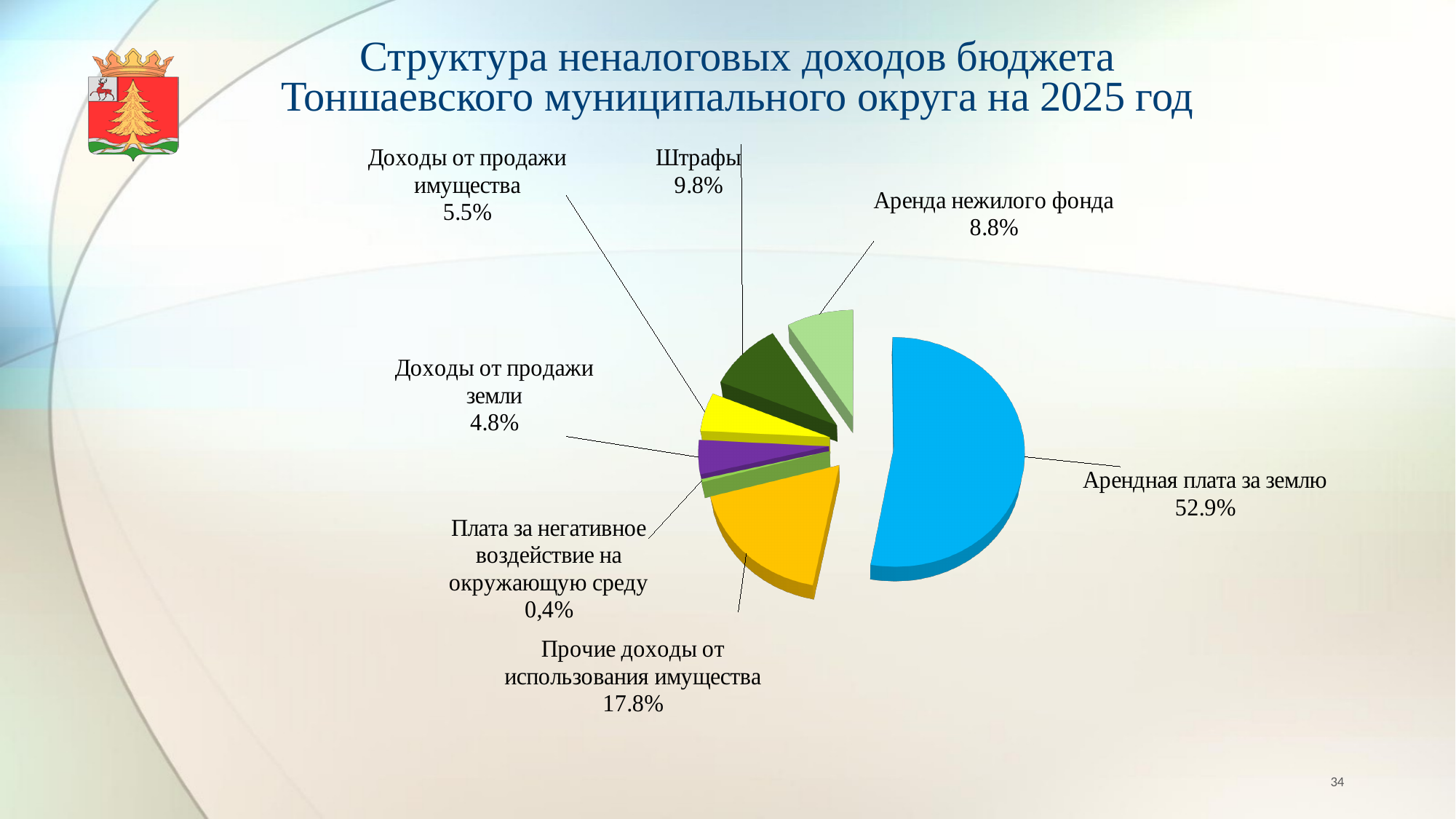
How many categories are shown in the pie chart? 7 What is the title of the chart on the slide? Структура неналоговых доходов бюджета Тоншаевского муниципального округа на 2025 год What is the value shown for "Прочие доходы от использования имущества"? 17.8% What is the value shown for "Штрафы"? 9.8% What is the difference between the shares of "Арендная плата за землю" and "Прочие доходы от использования имущества"? 35.1% Which category has the largest share of the pie? Арендная плата за землю What is the difference between the shares of "Штрафы" and "Аренда нежилого фонда"? 1.0% What share of the pie does "Арендная плата за землю" have? 52.9% Which is larger: the share of "Доходы от продажи имущества" or "Доходы от продажи земли"? Доходы от продажи имущества Which category has the smallest share of the pie? Плата за негативное воздействие на окружающую среду What kind of chart is shown on the slide? Pie chart What is the value shown for "Плата за негативное воздействие на окружающую среду"? 0,4%